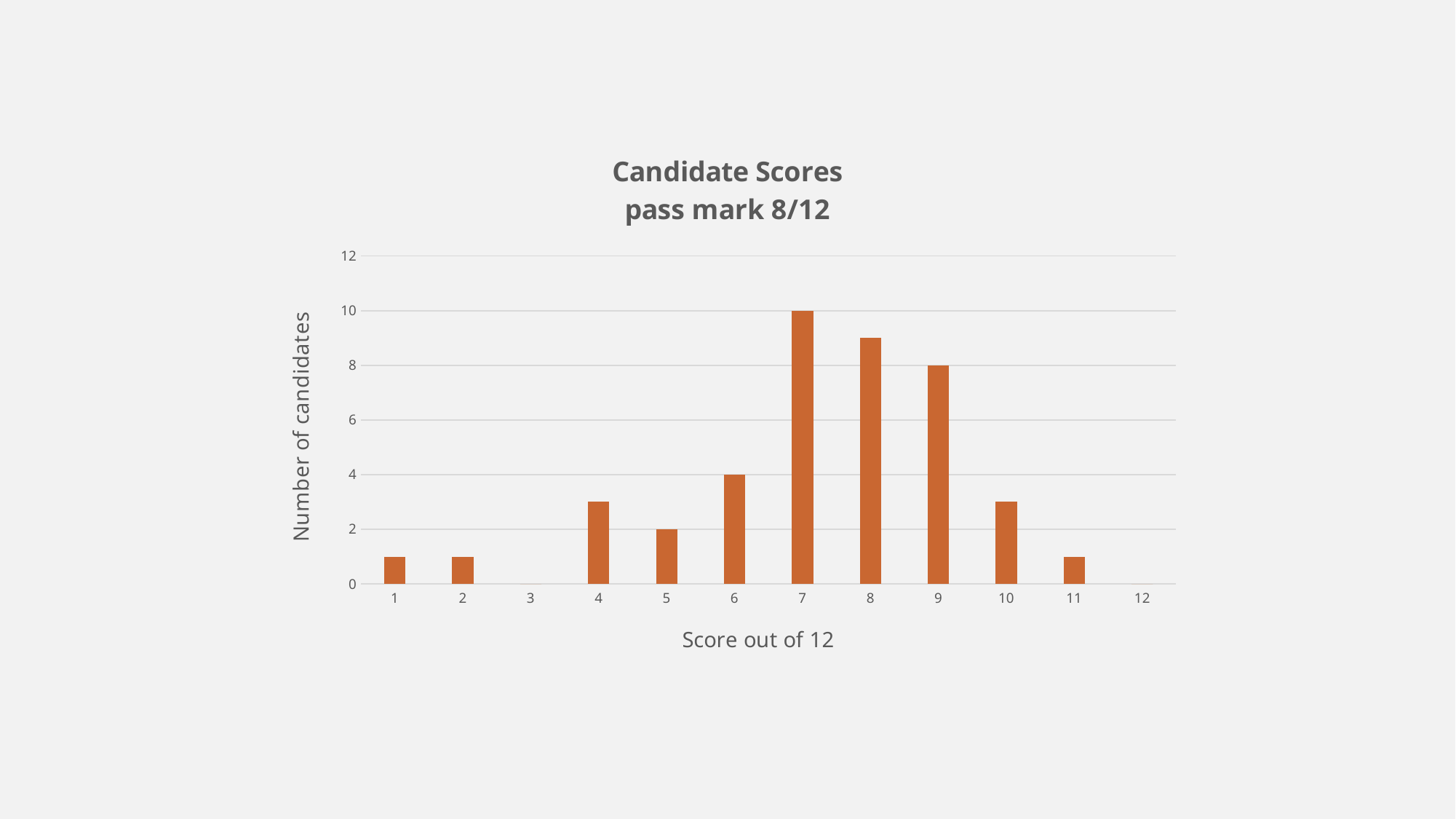
How many candidates scored 9? 8 What is the label of the x axis? Score out of 12 How many candidates scored 7? 10 What is the title of the chart? Candidate Scores pass mark 8/12 How many candidates scored 6? 4 How many score categories are shown on the x axis? 12 Which has more candidates, a score of 7 or a score of 9? 7 What is the difference between the number of candidates scoring 7 and the number scoring 9? 2 Is the number of candidates scoring 10 greater or less than 4? less How many candidates scored 5? 2 What kind of chart is shown on the slide? bar chart Which score has the highest number of candidates? 7